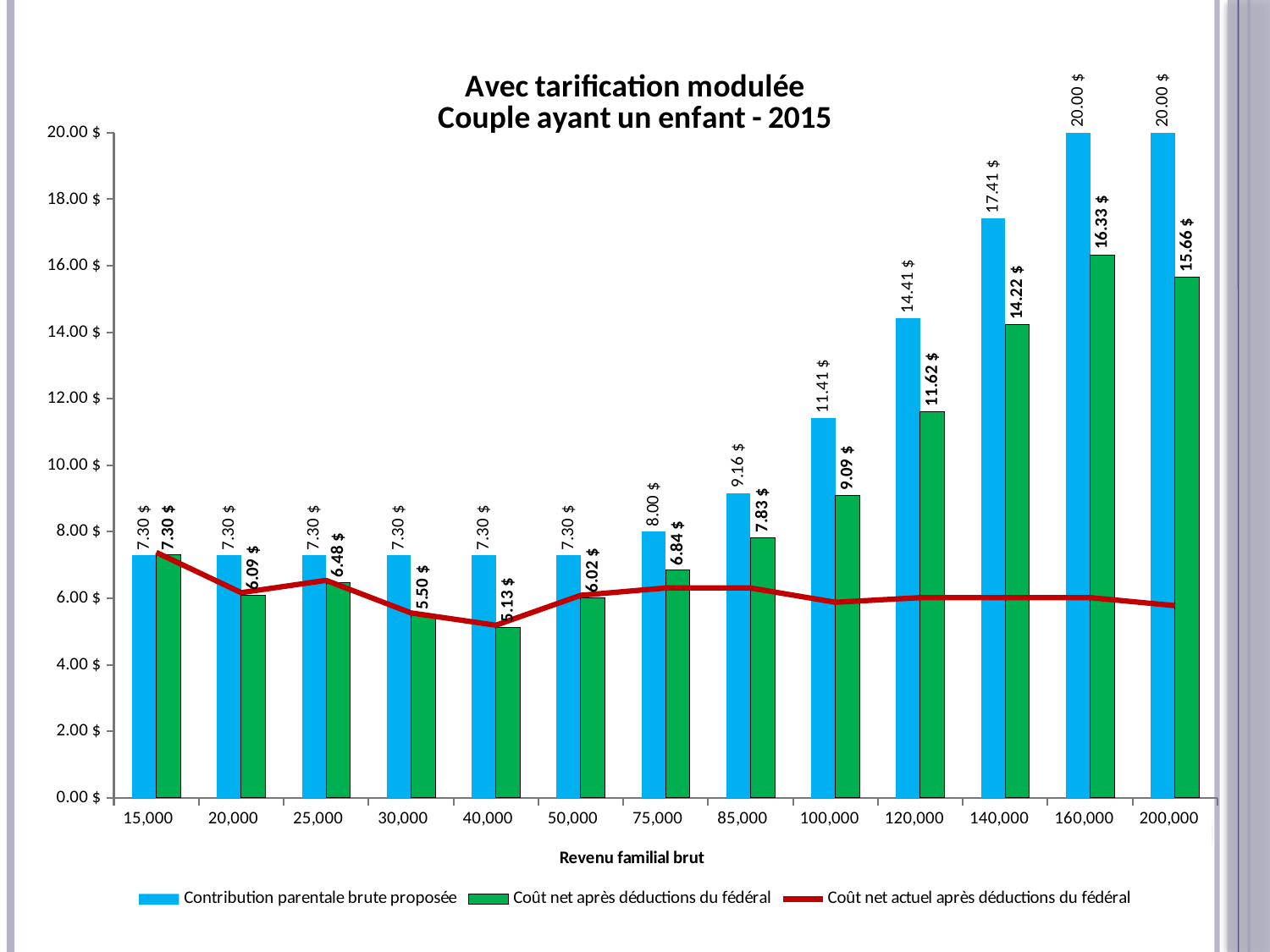
How many series does the legend list? 3 At which gross family income is Coût net après déductions du fédéral lowest? 40,000 Do the values of Contribution parentale brute proposée rise or fall from 50,000 to 200,000? rise How many gross family income categories are shown on the x axis? 13 At which gross family income is Coût net après déductions du fédéral highest? 160,000 What is the title of the x axis? Revenu familial brut What is the value of Coût net après déductions du fédéral at a gross family income of 140,000? 14.22 $ What kind of chart is shown on the slide? bar chart with a line What is the value of Contribution parentale brute proposée at a gross family income of 100,000? 11.41 $ Which has the larger Coût net après déductions du fédéral: a gross family income of 20,000 or 25,000? 25,000 At a gross family income of 200,000, what is the difference between Contribution parentale brute proposée and Coût net après déductions du fédéral? 4.34 $ Is the value of Coût net actuel après déductions du fédéral at a gross family income of 40,000 greater or less than 6.00 $? less